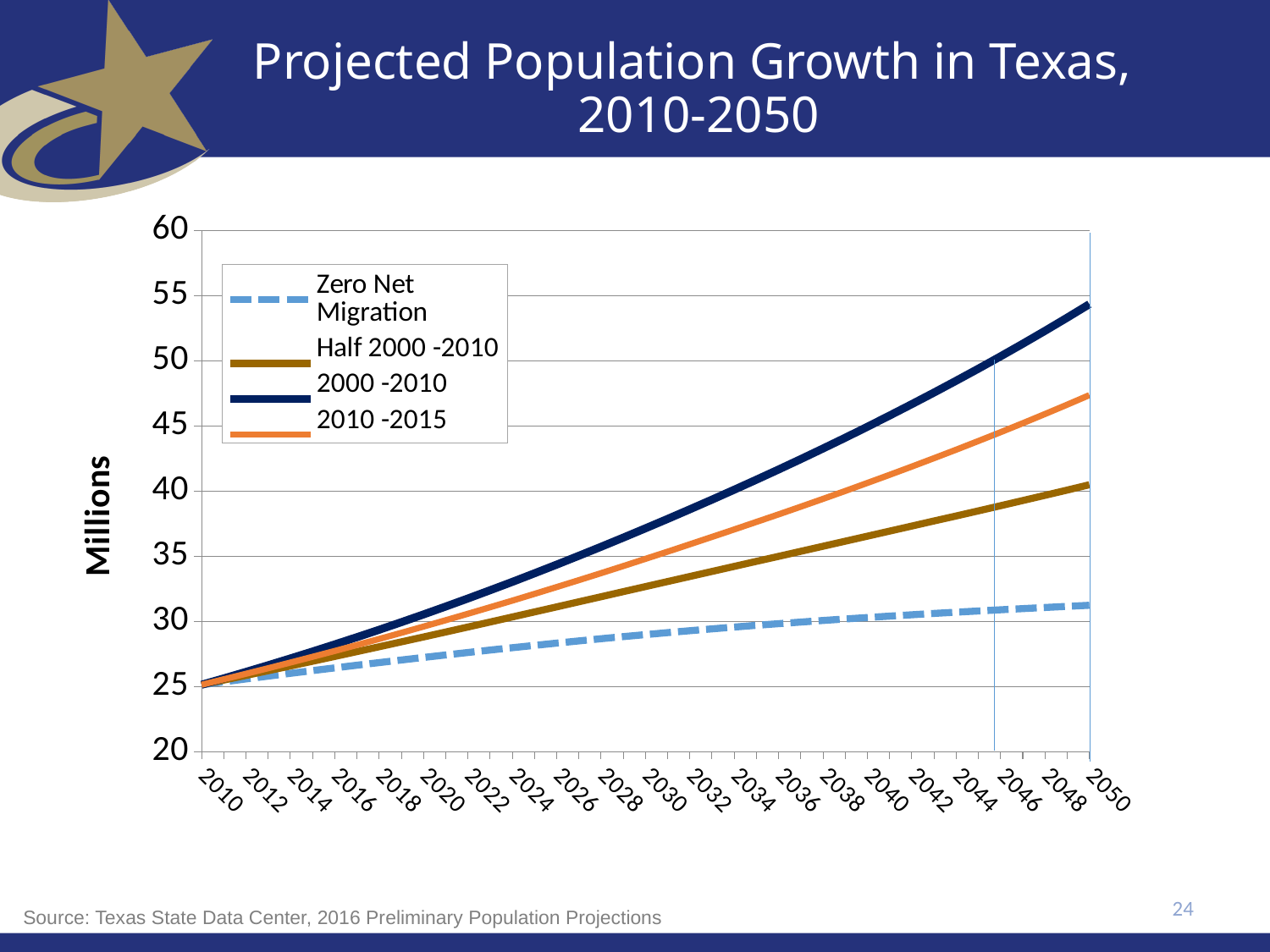
Is the value for the 2000 -2010 series in 2050 greater or less than 50? greater Is the value for the 2010 -2015 series in 2050 greater or less than 45? greater How many series does the legend list? 4 What is the title of the chart? Projected Population Growth in Texas, 2010-2050 Is the value for the Zero Net Migration series in 2050 greater or less than 35? less What kind of chart is shown on the slide? line chart In 2050, which series is larger: 2010 -2015 or Half 2000 -2010? 2010 -2015 Does the Zero Net Migration series rise or fall from 2010 to 2050? rises Which series has the highest value in 2050? 2000 -2010 Which series has the lowest value in 2050? Zero Net Migration Which series is drawn with a dashed line? Zero Net Migration